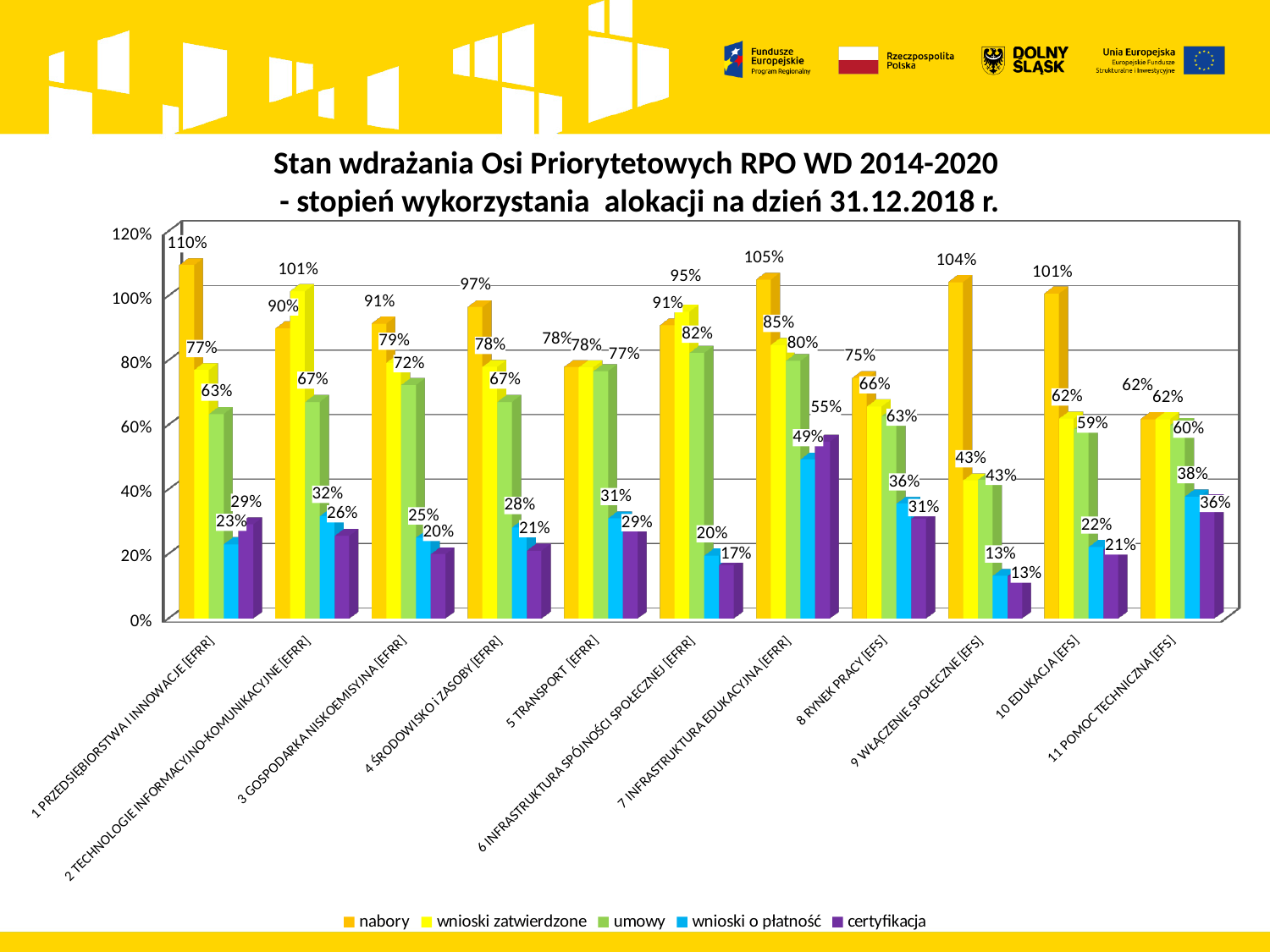
Which category has the highest value for nabory? 1 PRZEDSIĘBIORSTWA I INNOWACJE [EFRR] What is the value of umowy for 6 INFRASTRUKTURA SPÓJNOŚCI SPOŁECZNEJ [EFRR]? 82% What is the difference between nabory and wnioski zatwierdzone for 9 WŁĄCZENIE SPOŁECZNE [EFS]? 61% What is the value of nabory for 1 PRZEDSIĘBIORSTWA I INNOWACJE [EFRR]? 110% Which series is shown in purple in the legend? certyfikacja What is the value of wnioski o płatność for 9 WŁĄCZENIE SPOŁECZNE [EFS]? 13% How many series does the legend list? 5 How many categories are shown on the x axis? 11 What kind of chart is shown on the slide? bar chart What is the value of certyfikacja for 7 INFRASTRUKTURA EDUKACYJNA [EFRR]? 55% Which category has the lowest value for certyfikacja? 9 WŁĄCZENIE SPOŁECZNE [EFS] Which is larger for 2 TECHNOLOGIE INFORMACYJNO-KOMUNIKACYJNE [EFRR]: nabory or wnioski zatwierdzone? wnioski zatwierdzone